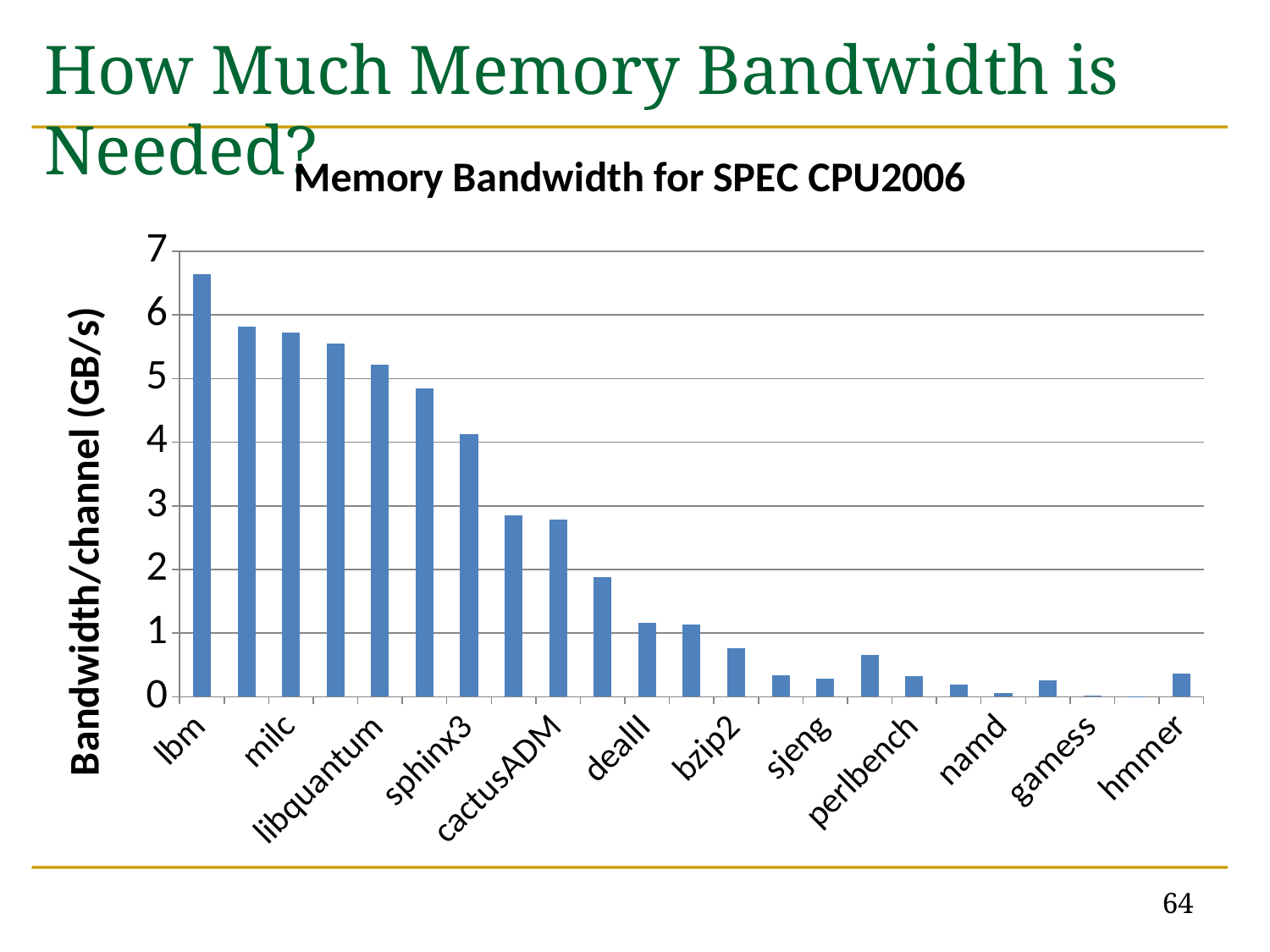
Which benchmark has the highest memory bandwidth? lbm Is the value for lbm greater or less than 6? greater Is the value for sphinx3 greater or less than 4? greater Do the bandwidth values generally rise or fall from left to right across the benchmarks? fall Is the value for bzip2 greater or less than 1? less Which has a higher memory bandwidth, libquantum or sjeng? libquantum What is the label of the vertical axis? Bandwidth/channel (GB/s) What type of chart is shown on the slide? bar chart What is the title of the chart? Memory Bandwidth for SPEC CPU2006